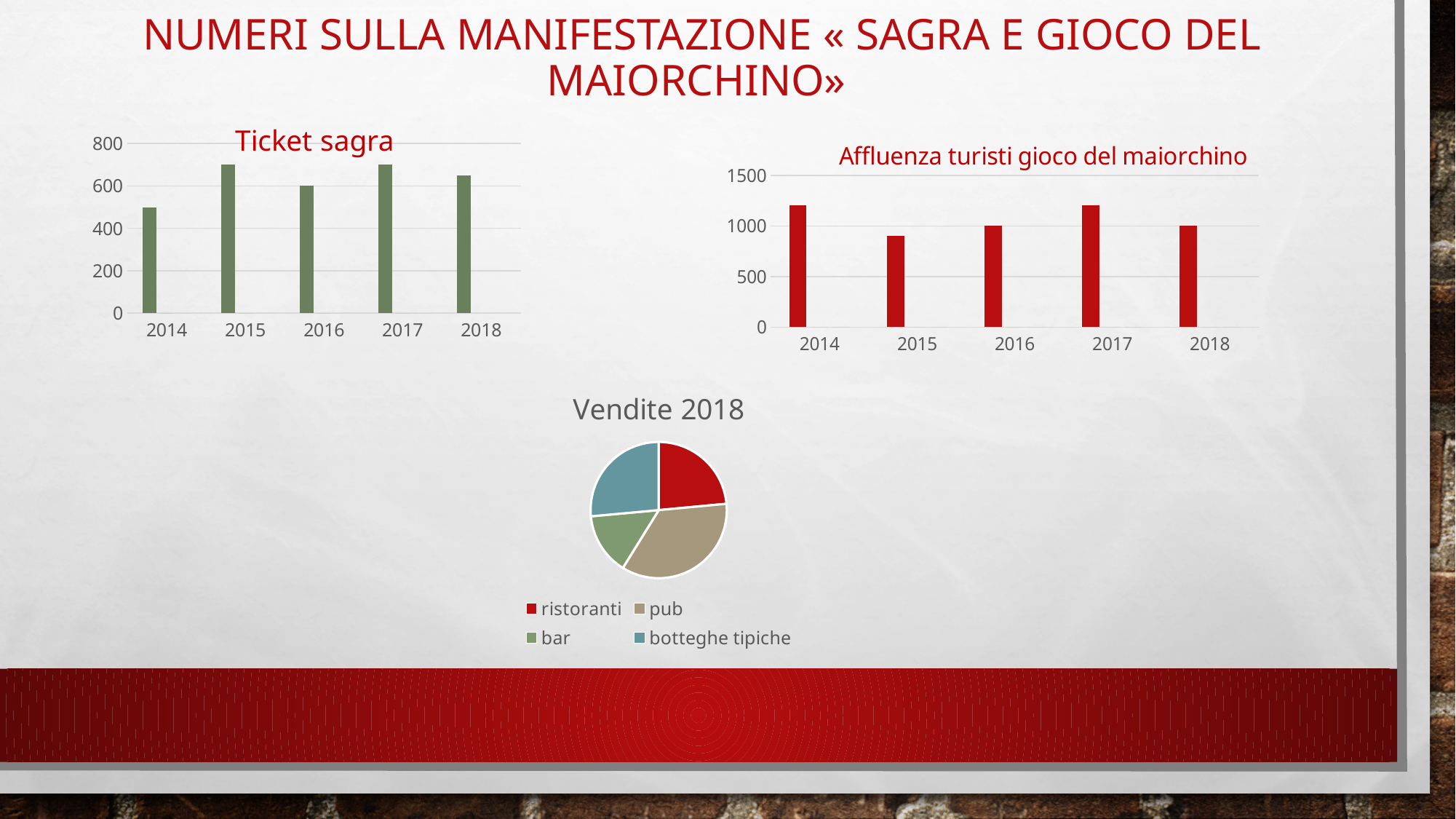
What kind of chart is the "Ticket sagra" chart? bar chart How many categories does the legend of the "Vendite 2018" chart list? 4 In the "Ticket sagra" chart, is the value for 2014 greater or less than 600? less In the "Ticket sagra" chart, is the value for 2015 greater or less than 600? greater In the "Ticket sagra" chart, which year has the lowest value? 2014 In the "Affluenza turisti gioco del maiorchino" chart, is the value for 2014 greater or less than 1000? greater What kind of chart is the "Vendite 2018" chart? pie chart How many years are shown on the "Affluenza turisti gioco del maiorchino" chart? 5 In the "Affluenza turisti gioco del maiorchino" chart, which year has the lowest value? 2015 In the "Ticket sagra" chart, which is larger, the value for 2015 or the value for 2016? 2015 How many years are shown on the "Ticket sagra" chart? 5 In the "Vendite 2018" pie chart, which category has the smallest slice? bar